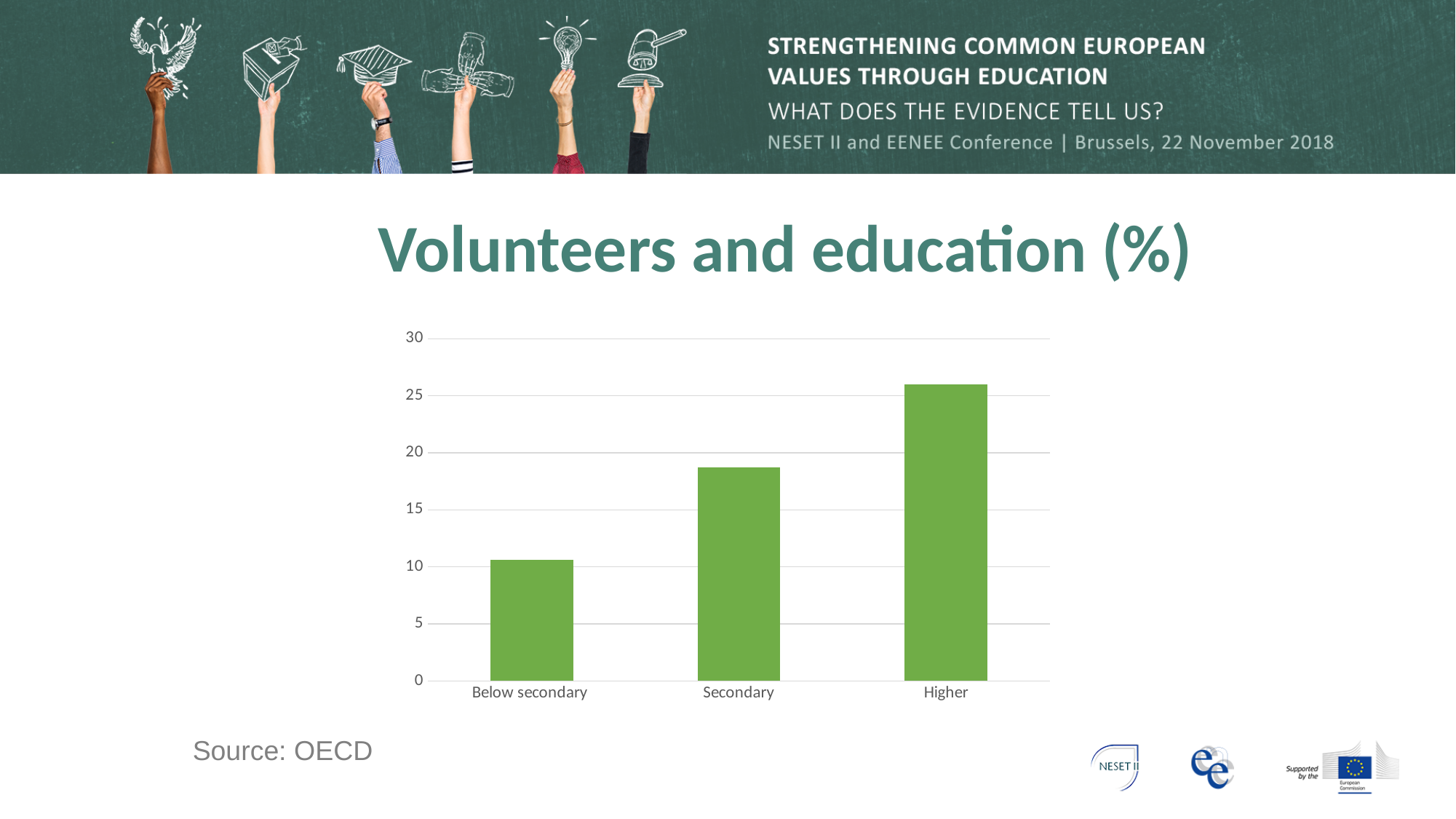
Is the value for Secondary greater or less than 15? greater Which is larger, the value for Secondary or the value for Higher? Higher How many categories are shown on the x axis? 3 What is the source cited for the chart? OECD Do the values rise or fall from Below secondary to Higher along the x axis? rise Is the value for Below secondary greater or less than 15? less Is the value for Higher greater or less than 25? greater What is the title of the chart? Volunteers and education (%) What kind of chart is shown on the slide? bar chart Which education level has the lowest share of volunteers? Below secondary Which education level has the highest share of volunteers? Higher